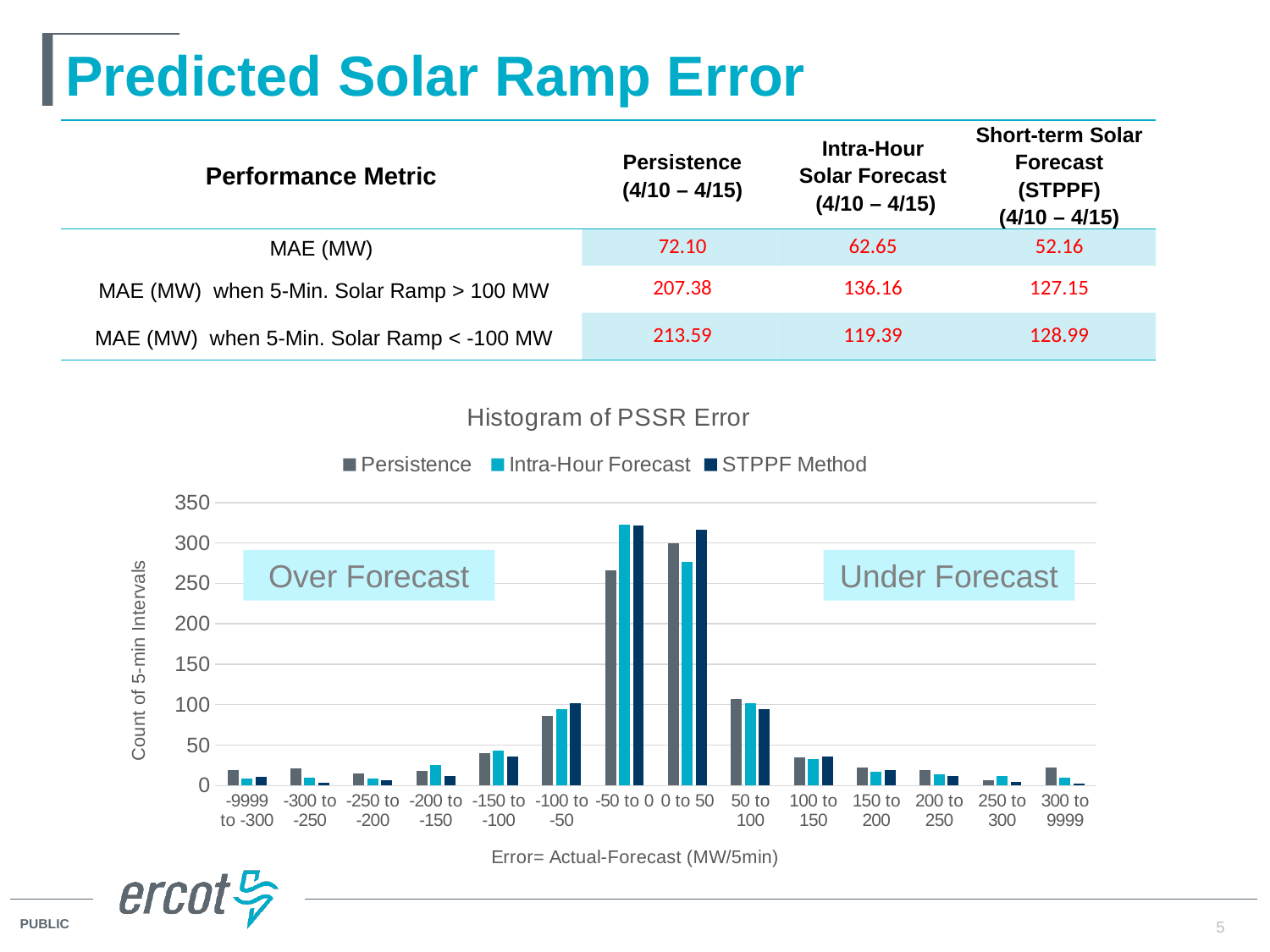
In the Histogram of PSSR Error, for the 0 to 50 bin, which is larger: the Persistence count or the Intra-Hour Forecast count? Persistence In the Histogram of PSSR Error, is the Persistence count for the 0 to 50 bin greater or less than 250? greater In the Histogram of PSSR Error, which error bin has the highest count for the Persistence series? 0 to 50 In the Histogram of PSSR Error, for the -50 to 0 bin, which is larger: the Persistence count or the Intra-Hour Forecast count? Intra-Hour Forecast What type of chart is the Histogram of PSSR Error? bar chart In the Histogram of PSSR Error, which error bin has the highest count for the Intra-Hour Forecast series? -50 to 0 What is the x-axis label of the Histogram of PSSR Error? Error= Actual-Forecast (MW/5min) In the Histogram of PSSR Error, is the Intra-Hour Forecast count for the -50 to 0 bin greater or less than 300? greater How many error bins are shown on the x axis of the Histogram of PSSR Error? 14 How many series does the legend of the Histogram of PSSR Error list? 3 In the Histogram of PSSR Error, is the Intra-Hour Forecast count for the -150 to -100 bin greater or less than 50? less What is the title of the chart on the slide? Histogram of PSSR Error